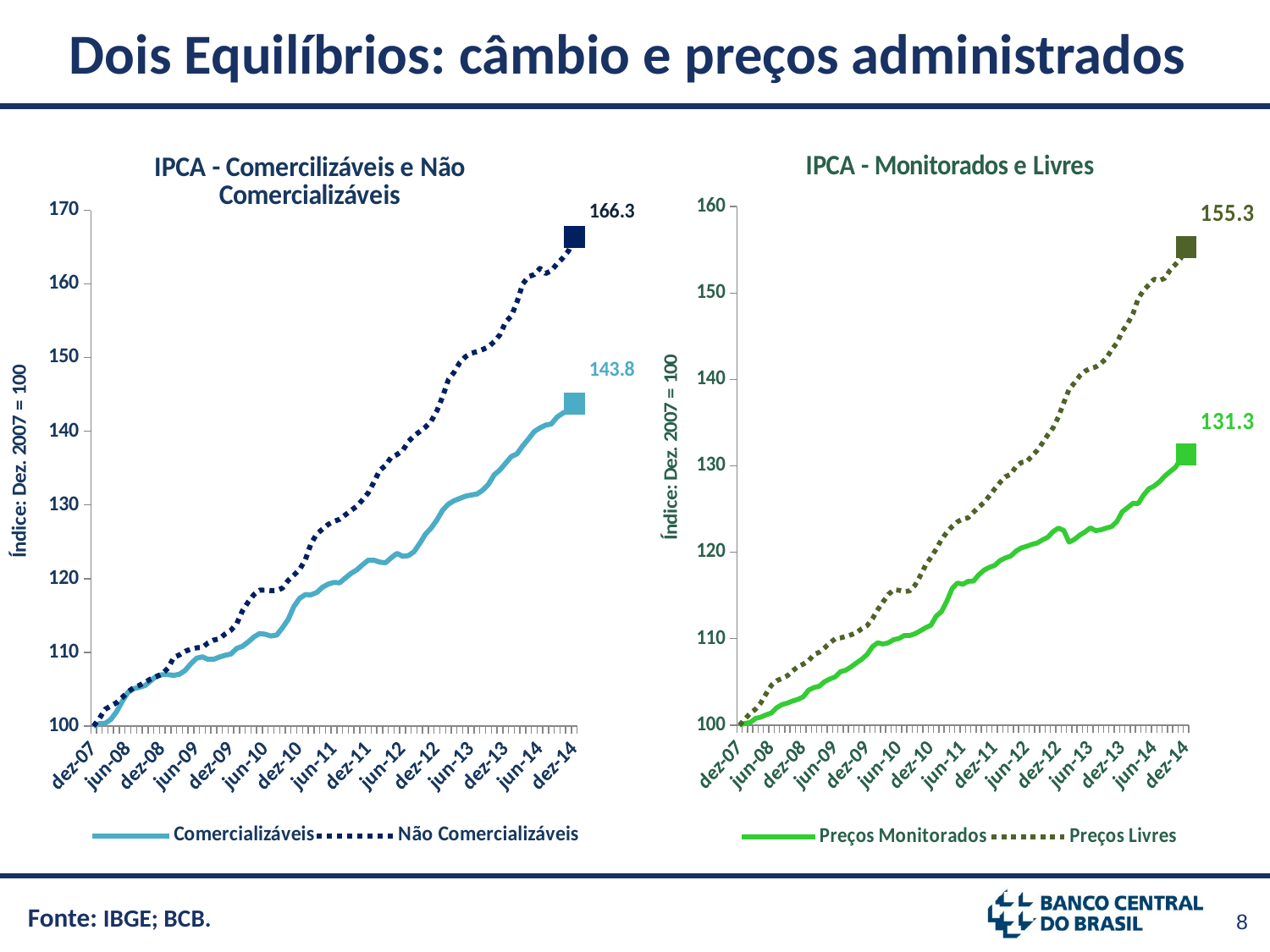
In the left chart, what is the difference between the dez-14 values of Não Comercializáveis and Comercializáveis? 22.5 In the left chart, do the values of Não Comercializáveis rise or fall from dez-07 to dez-14? Rise In the chart 'IPCA - Monitorados e Livres', what is the value of Preços Livres at dez-14? 155.3 In the chart 'IPCA - Monitorados e Livres', what is the value of Preços Monitorados at dez-14? 131.3 In the chart 'IPCA - Monitorados e Livres', which series is higher at dez-14, Preços Monitorados or Preços Livres? Preços Livres In the chart 'IPCA - Comercilizáveis e Não Comercializáveis', what is the value of Comercializáveis at dez-14? 143.8 In the right chart, what is the difference between the dez-14 values of Preços Livres and Preços Monitorados? 24.0 What is the y-axis label of the left chart? Índice: Dez. 2007 = 100 How many series does the legend of the right chart list? 2 In the chart 'IPCA - Comercilizáveis e Não Comercializáveis', what is the value of Não Comercializáveis at dez-14? 166.3 In the right chart, is the value for Preços Livres at dez-13 greater or less than 140? greater What kind of chart is 'IPCA - Comercilizáveis e Não Comercializáveis'? Line chart